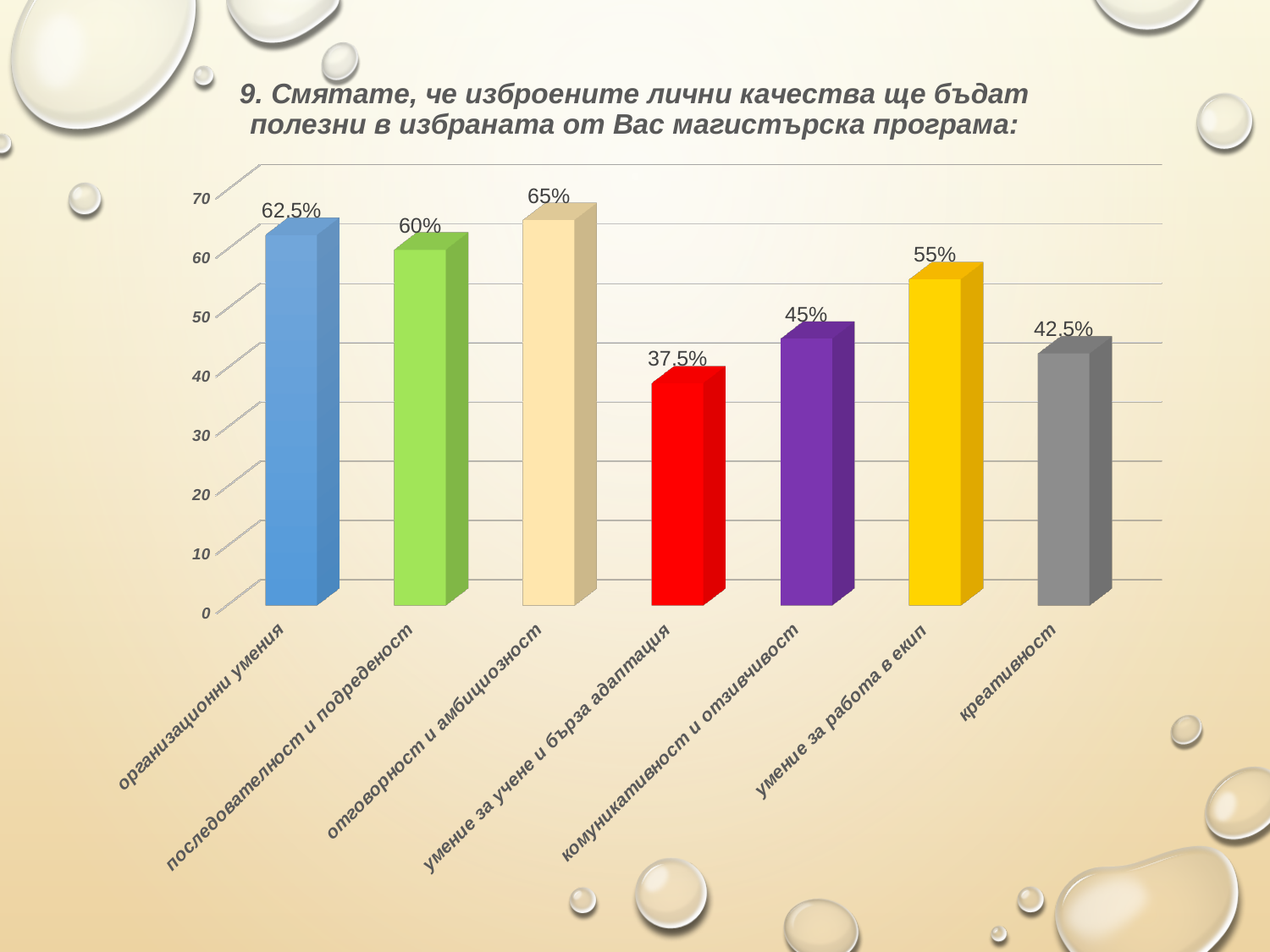
Which category has the lowest value? умение за учене и бърза адаптация What is the difference between the values for отговорност и амбициозност and умение за учене и бърза адаптация? 27,5% Which is larger, the value for комуникативност и отзивчивост or the value for креативност? комуникативност и отзивчивост How many categories are shown in the chart? 7 What is the value for умение за учене и бърза адаптация? 37,5% Is the value for последователност и подреденост greater or less than 50? greater What colour is the bar for умение за учене и бърза адаптация? red Which category has the highest value? отговорност и амбициозност What is the value for умение за работа в екип? 55% What is the value for организационни умения? 62,5% What is the value for креативност? 42,5% What kind of chart is shown on the slide? bar chart